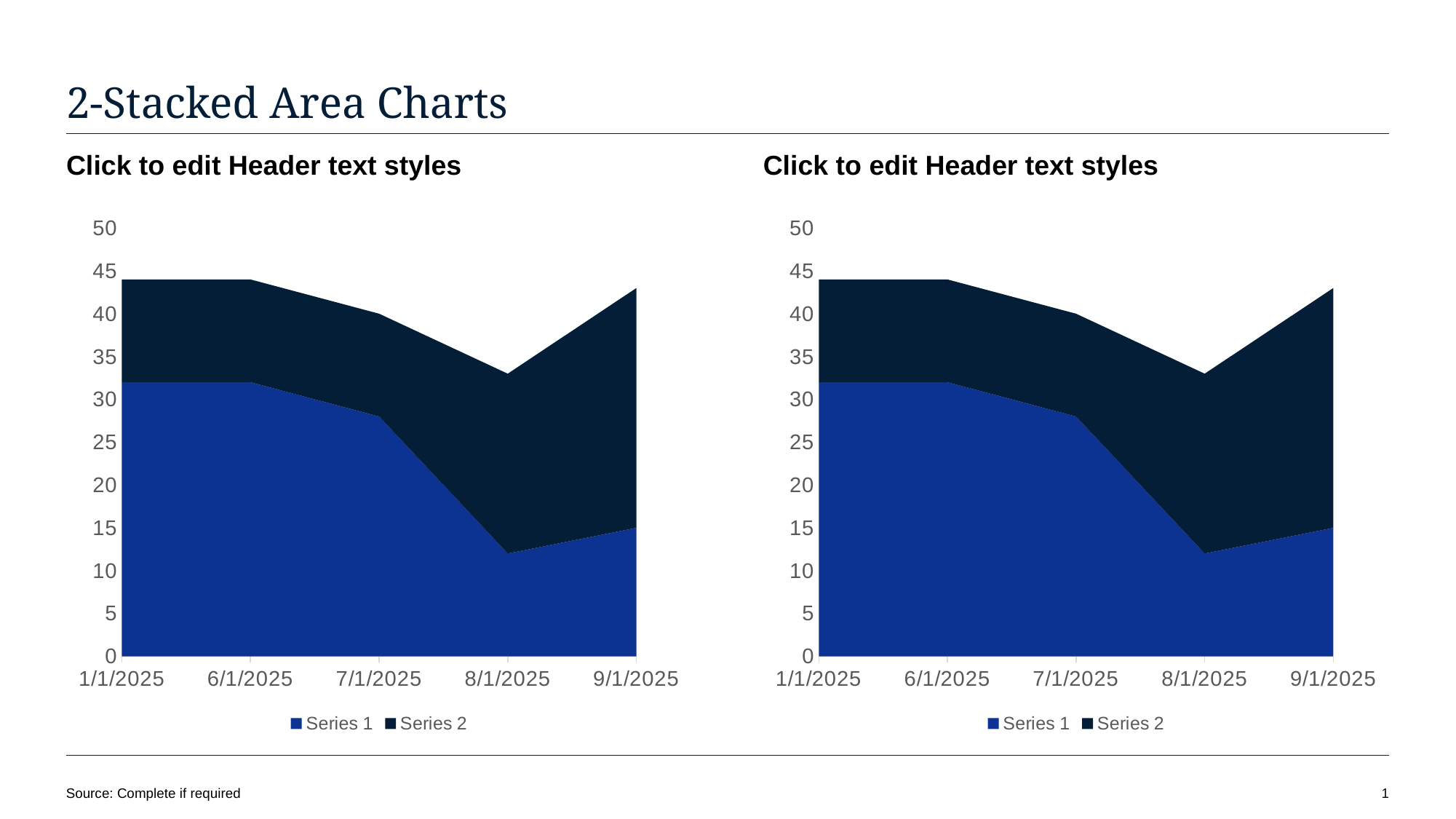
How many dates are shown on the x axis of the right chart? 5 In the right chart, is the stacked total at 8/1/2025 greater or less than 35? less In the left chart, does Series 1 rise or fall from 6/1/2025 to 8/1/2025? fall In the right chart, is the value for Series 1 at 7/1/2025 greater or less than 25? greater What kind of chart is the left chart? Stacked area chart In the right chart, is Series 1 larger at 1/1/2025 or at 9/1/2025? 1/1/2025 How many series does the legend of the left chart list? 2 In the left chart, is the value for Series 1 at 8/1/2025 greater or less than 15? less In the left chart, at which date is Series 1 lowest? 8/1/2025 In the right chart, at which date is the stacked total of Series 1 and Series 2 lowest? 8/1/2025 What are the two legend entries of the right chart? Series 1, Series 2